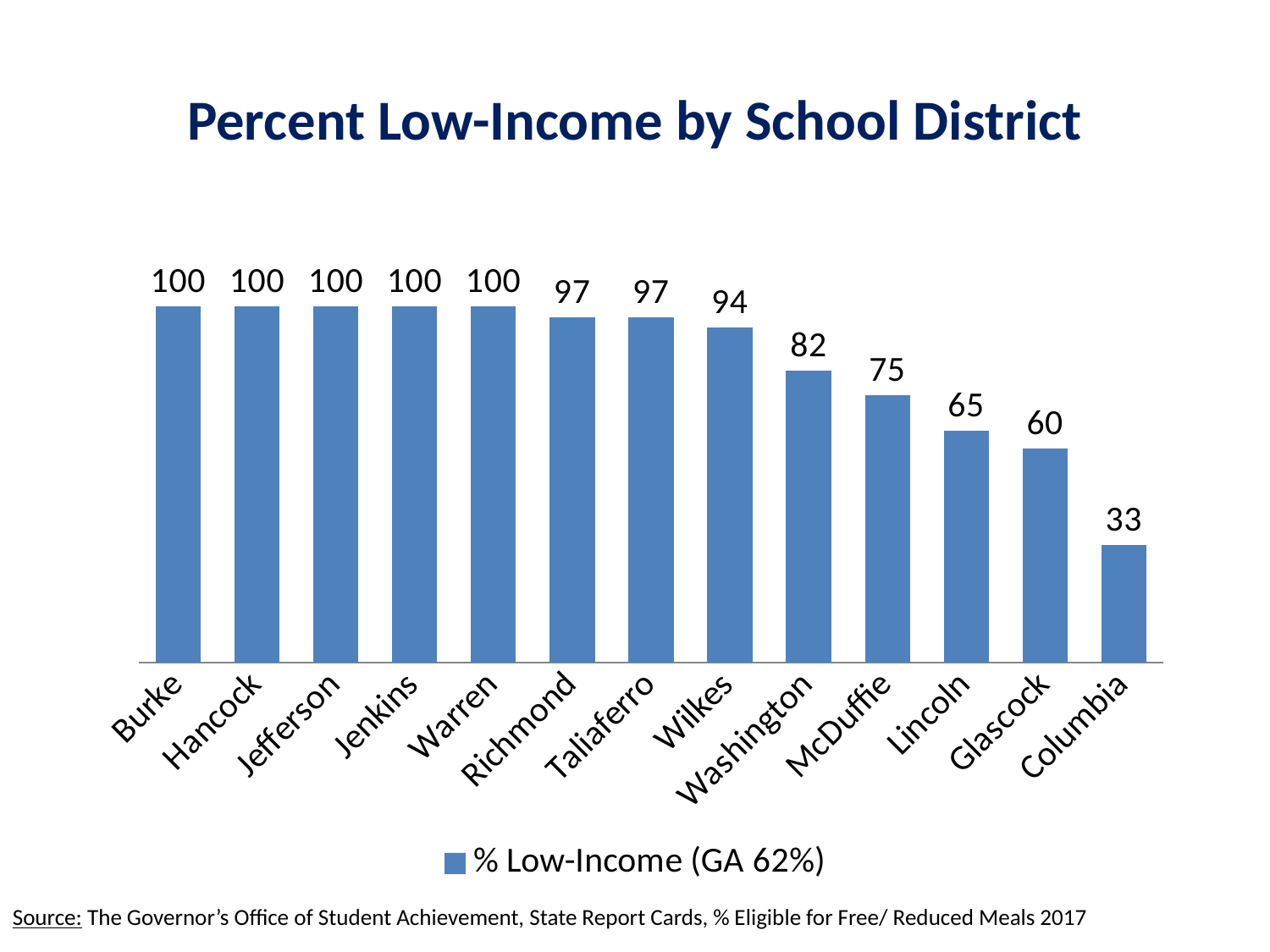
What is the difference between the percent low-income values for McDuffie and Glascock? 15 Which has a higher percent low-income, Washington or Lincoln? Washington How many school districts are shown in the chart? 13 What is the percent low-income value for Washington? 82 Which school district has the lowest percent low-income? Columbia What is the difference between the percent low-income values for Wilkes and Lincoln? 29 What is the percent low-income value for Richmond? 97 Do the values rise or fall moving from left to right along the x axis? Fall What is the percent low-income value for Columbia? 33 Which has a higher percent low-income, Glascock or Wilkes? Wilkes What kind of chart is shown on the slide? Bar chart How many school districts have a percent low-income value of 100? 5